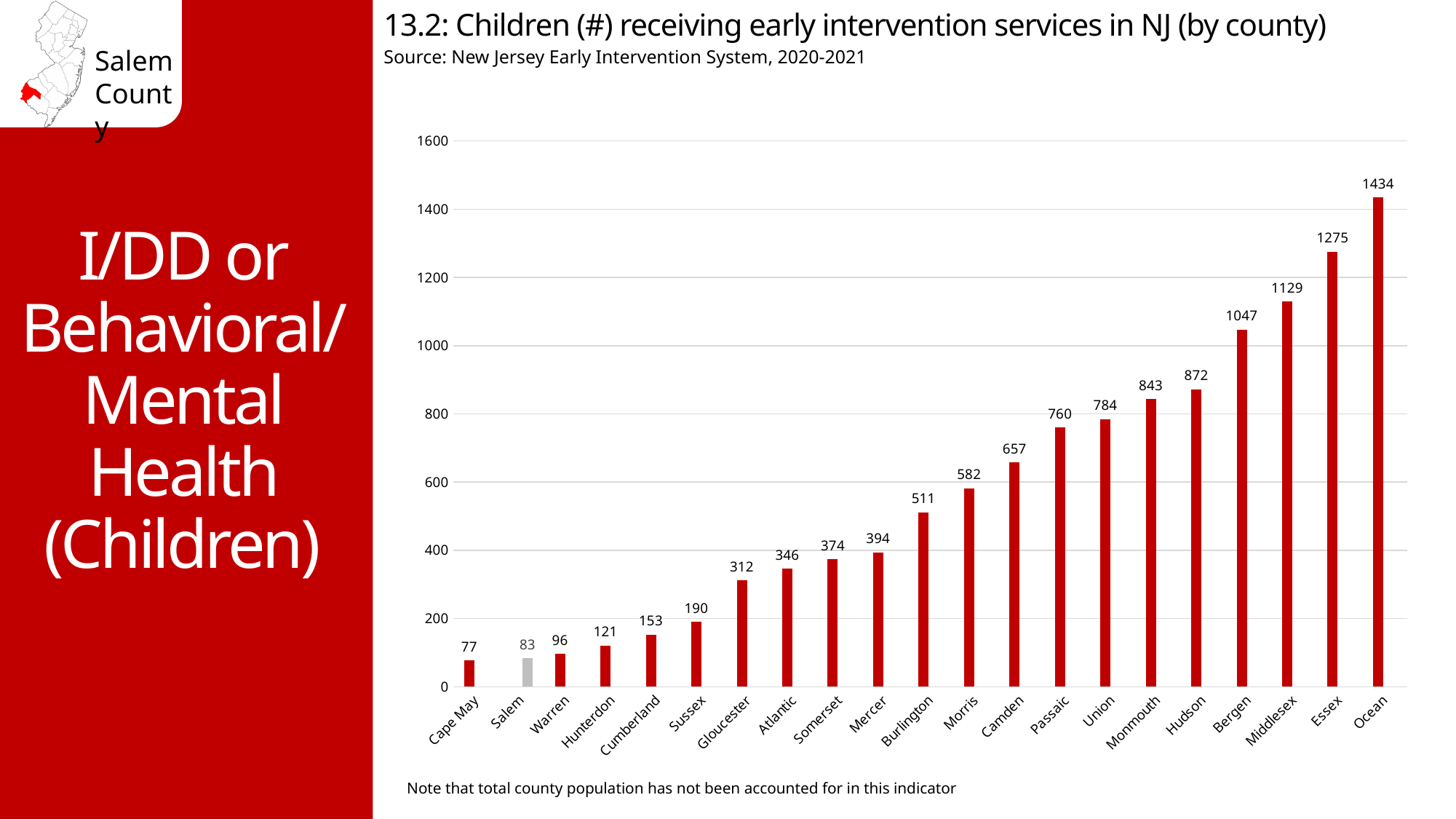
What is the value shown for Gloucester County? 312 How many counties are shown on the x axis? 21 Which county has the highest number of children receiving early intervention services? Ocean Is the value for Bergen greater or less than 1000? greater Which county has the lowest number of children receiving early intervention services? Cape May What kind of chart is shown on the slide? Bar chart Which county has a larger value, Camden or Morris? Camden Do the values rise or fall moving from left to right along the x axis? Rise How many children are receiving early intervention services in Salem County? 83 What is the value shown for Ocean County? 1434 What is the difference between the values for Salem and Cape May? 6 What is the difference between the values for Essex and Middlesex? 146